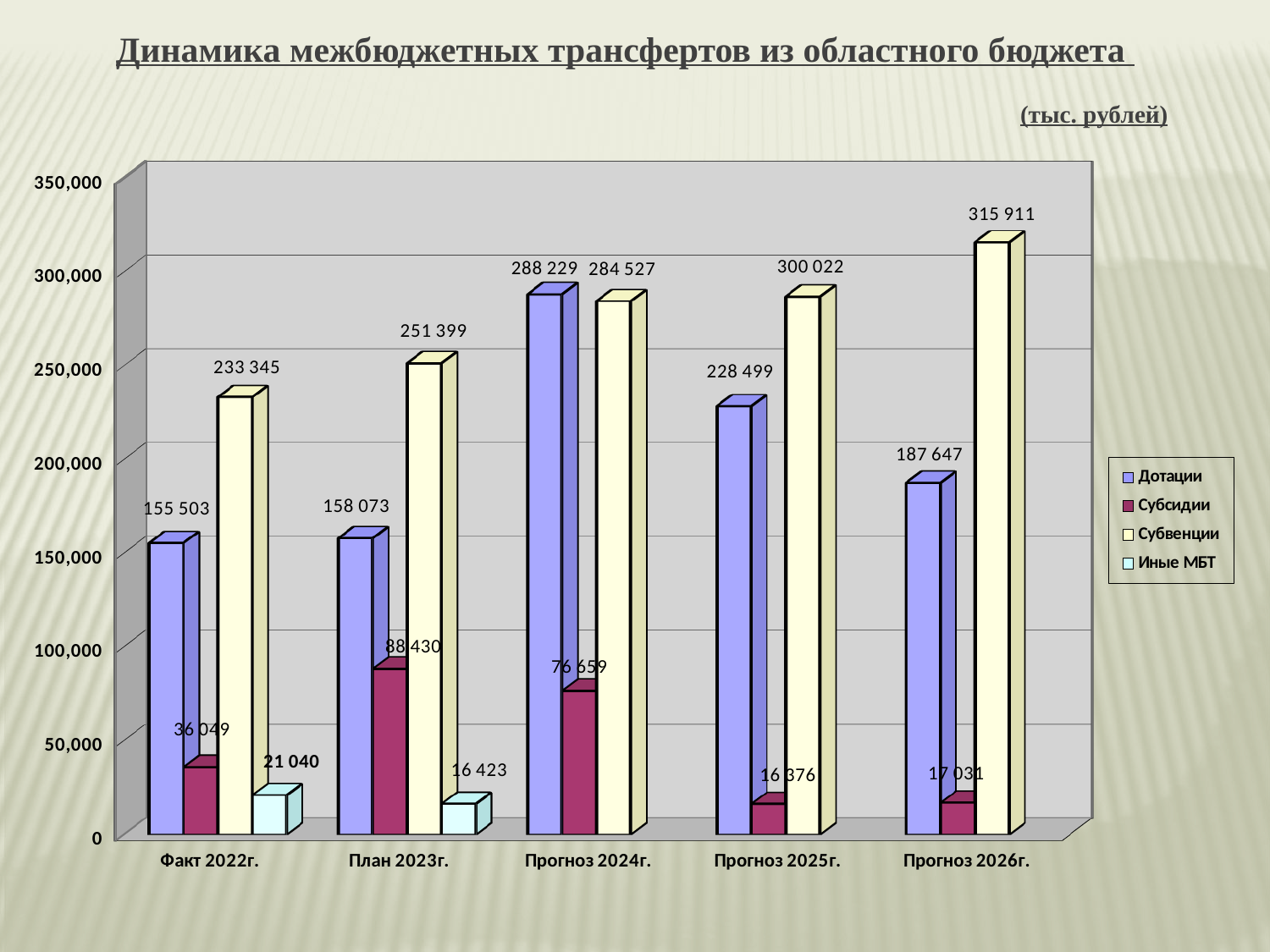
What is the value of Иные МБТ for План 2023г.? 16 423 What is the difference between Субвенции for Прогноз 2026г. and Субвенции for Факт 2022г.? 82 566 What is the value of Дотации for Факт 2022г.? 155 503 How many categories are shown on the x axis? 5 For Прогноз 2024г., which is larger: Дотации or Субвенции? Дотации How many series does the legend list? 4 Do the values for Субвенции rise or fall from Факт 2022г. to Прогноз 2026г.? Rise What is the value of Субвенции for Прогноз 2026г.? 315 911 Which category has the lowest value for Субсидии? Прогноз 2025г. Which category has the highest value for Дотации? Прогноз 2024г. What kind of chart is shown on the slide? Bar chart Which category has the highest value for Субвенции? Прогноз 2026г.